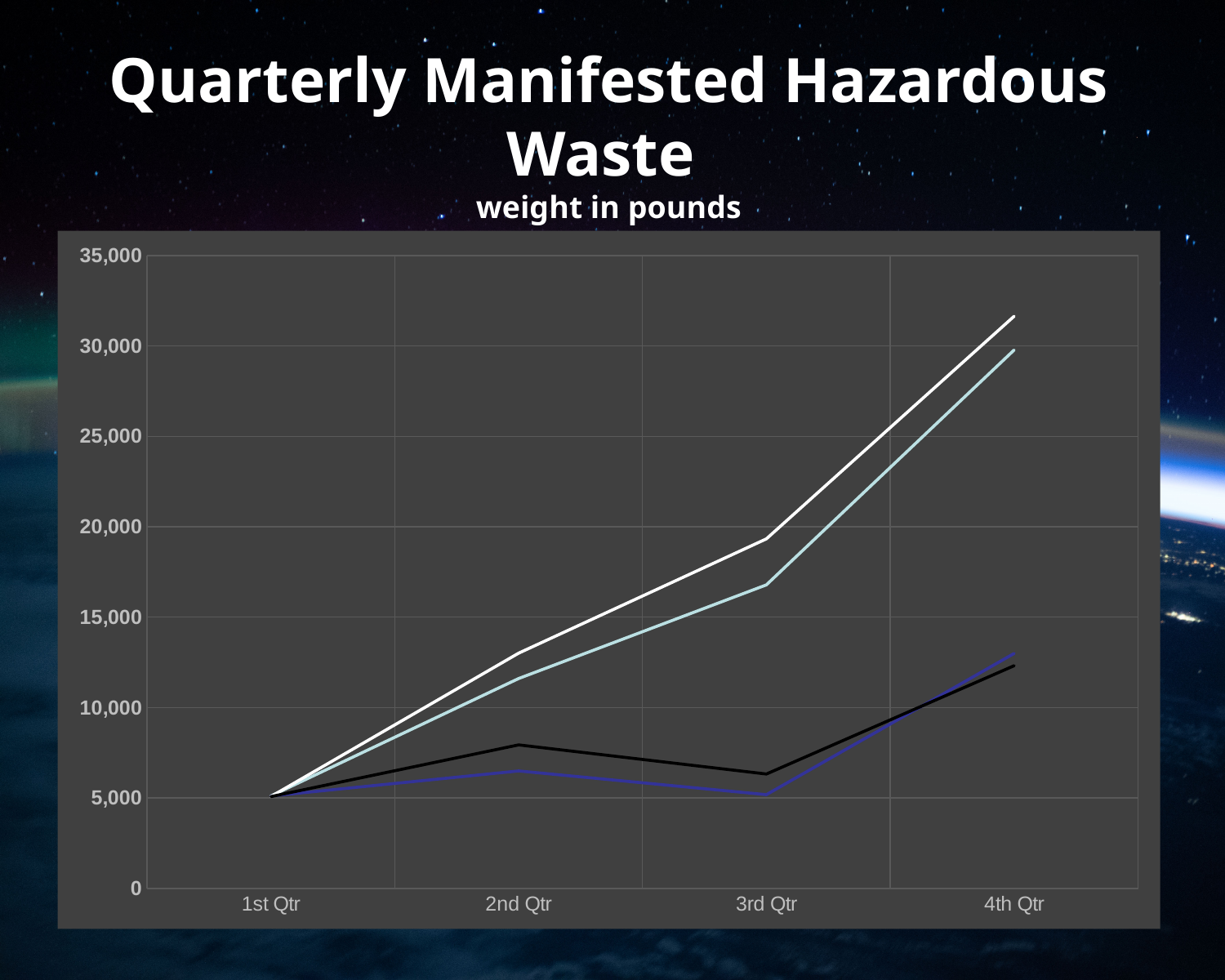
Is the value of the white line at 3rd Qtr greater or less than 15,000? greater How many lines are plotted on the chart? 4 At 4th Qtr, which line is higher, the white line or the light blue line? the white line Is the value of the white line at 4th Qtr greater or less than 30,000? greater Is the value of the blue line at 3rd Qtr greater or less than 10,000? less Does the white line rise or fall from 1st Qtr to 4th Qtr? rise In which quarter does the white line reach its highest value? 4th Qtr What kind of chart is shown on the slide? line chart How many quarters are shown on the x axis? 4 What is the subtitle shown under the chart title? weight in pounds